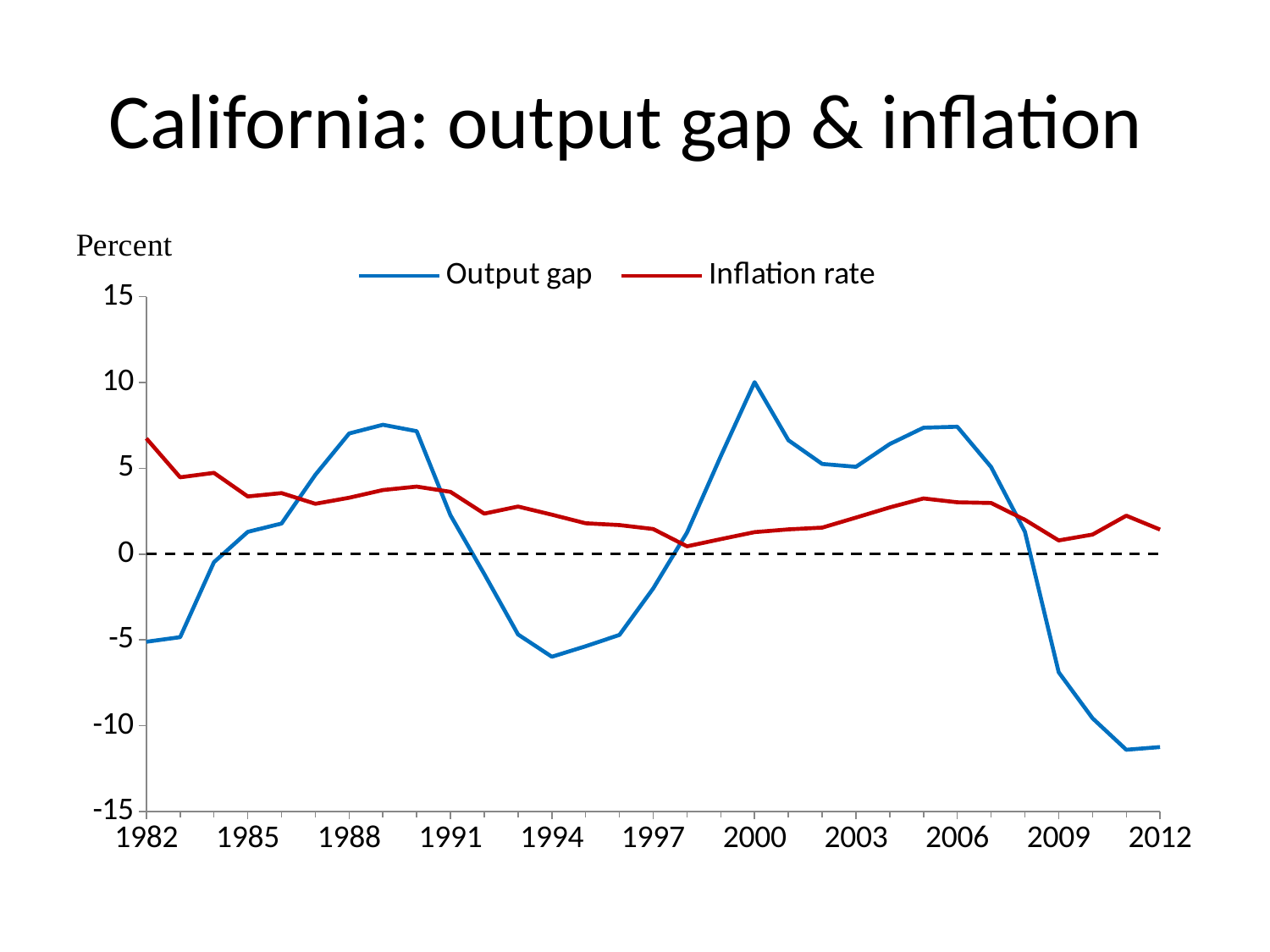
Does the Inflation rate rise or fall between 1982 and 1985? fall In which year is the Inflation rate at its highest? 1982 How many series does the legend list? 2 What kind of chart is shown on the slide? line chart Is the Output gap in 2000 greater or less than 5? greater In which year does the Output gap reach its highest value? 2000 In 1994, which series has the higher value, Output gap or Inflation rate? Inflation rate Is the Output gap in 2012 greater or less than -10? less Is the Output gap in 1994 greater or less than -5? less What unit label is shown above the y axis? Percent What is the title of the chart? California: output gap & inflation